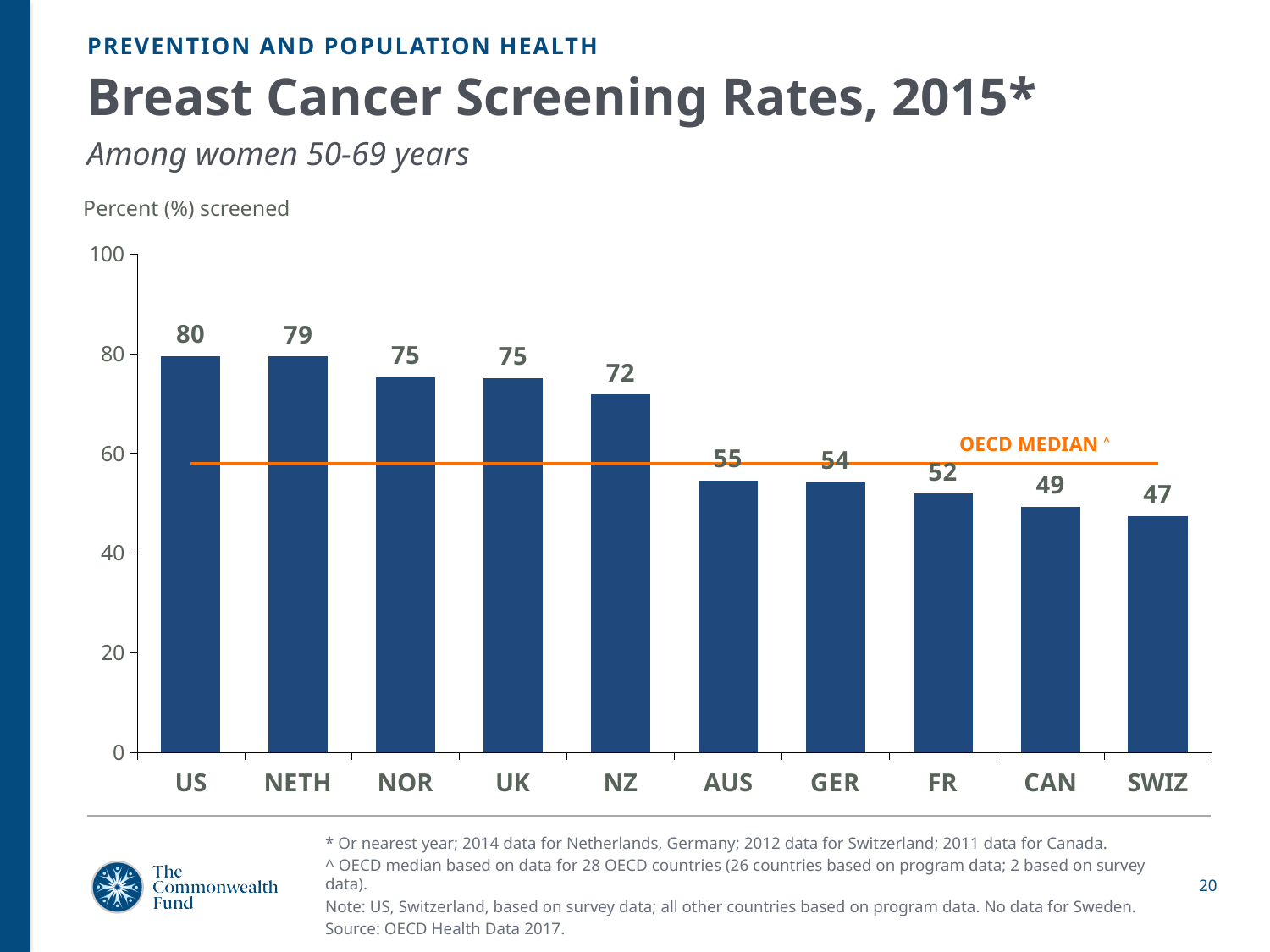
What is the breast cancer screening rate for CAN? 49 Which country has the lowest breast cancer screening rate? SWIZ How many countries are shown in the chart? 10 Is the value for NOR greater or less than 60? greater Which has a higher screening rate, AUS or FR? AUS What kind of chart is shown on the slide? Bar chart Which country has the highest breast cancer screening rate? US What is the breast cancer screening rate for NZ? 72 What is the difference between the screening rates for NETH and GER? 25 Do the values rise or fall from left to right across the countries? Fall What is the breast cancer screening rate for the US? 80 What does the orange horizontal line on the chart represent? OECD median